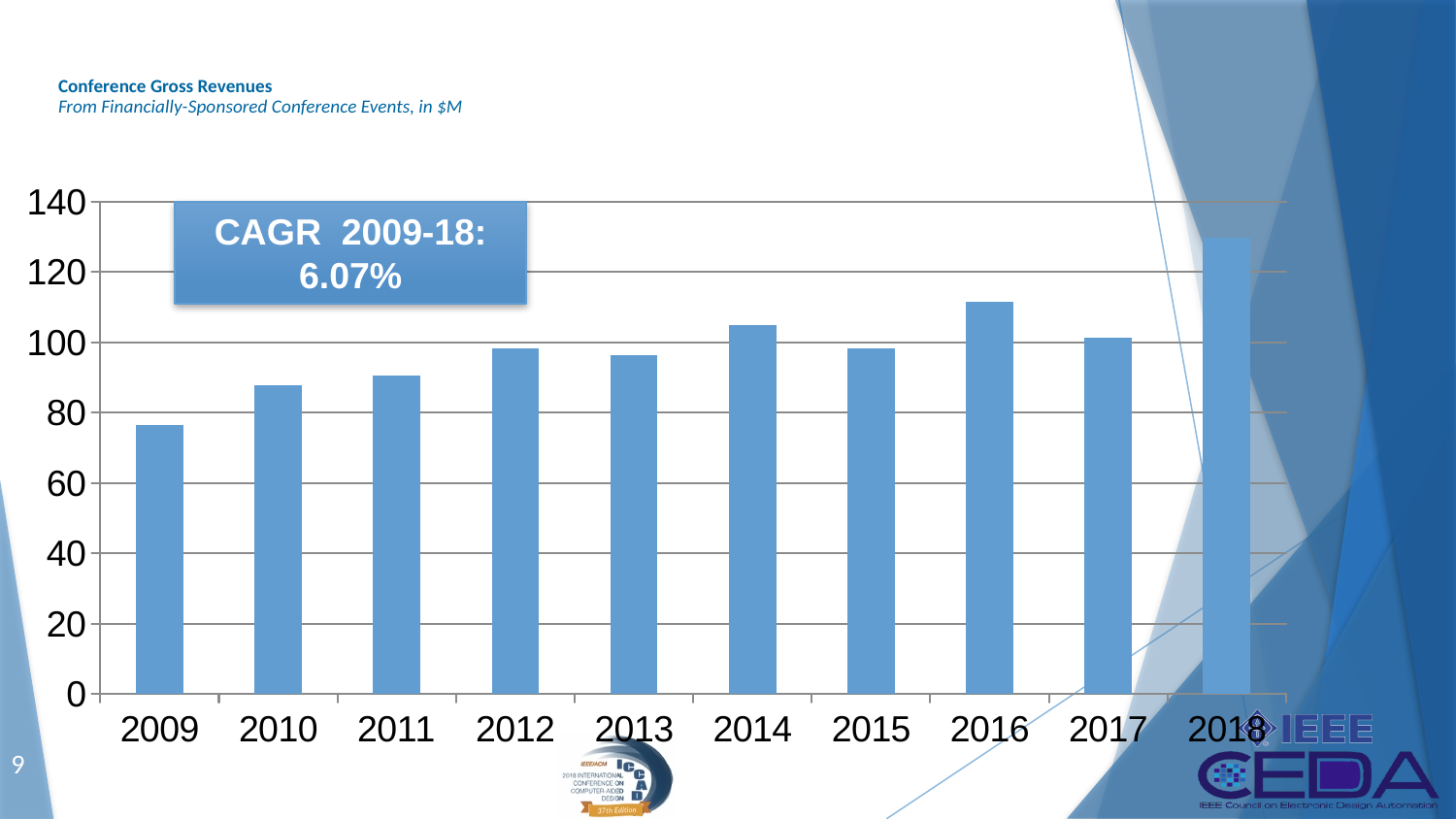
What kind of chart is shown on the slide? bar chart Is the value for 2009 greater or less than 80? less Is the value for 2016 greater or less than 100? greater How many years are plotted on the x axis? 10 Is the value for 2018 greater or less than 120? greater Which year has the highest conference gross revenue? 2018 Which year has the larger value, 2016 or 2015? 2016 Which year has the larger value, 2018 or 2017? 2018 What CAGR for 2009-18 is stated in the box on the chart? 6.07% Which year has the lowest conference gross revenue? 2009 Do the values generally rise or fall from 2009 to 2018? rise